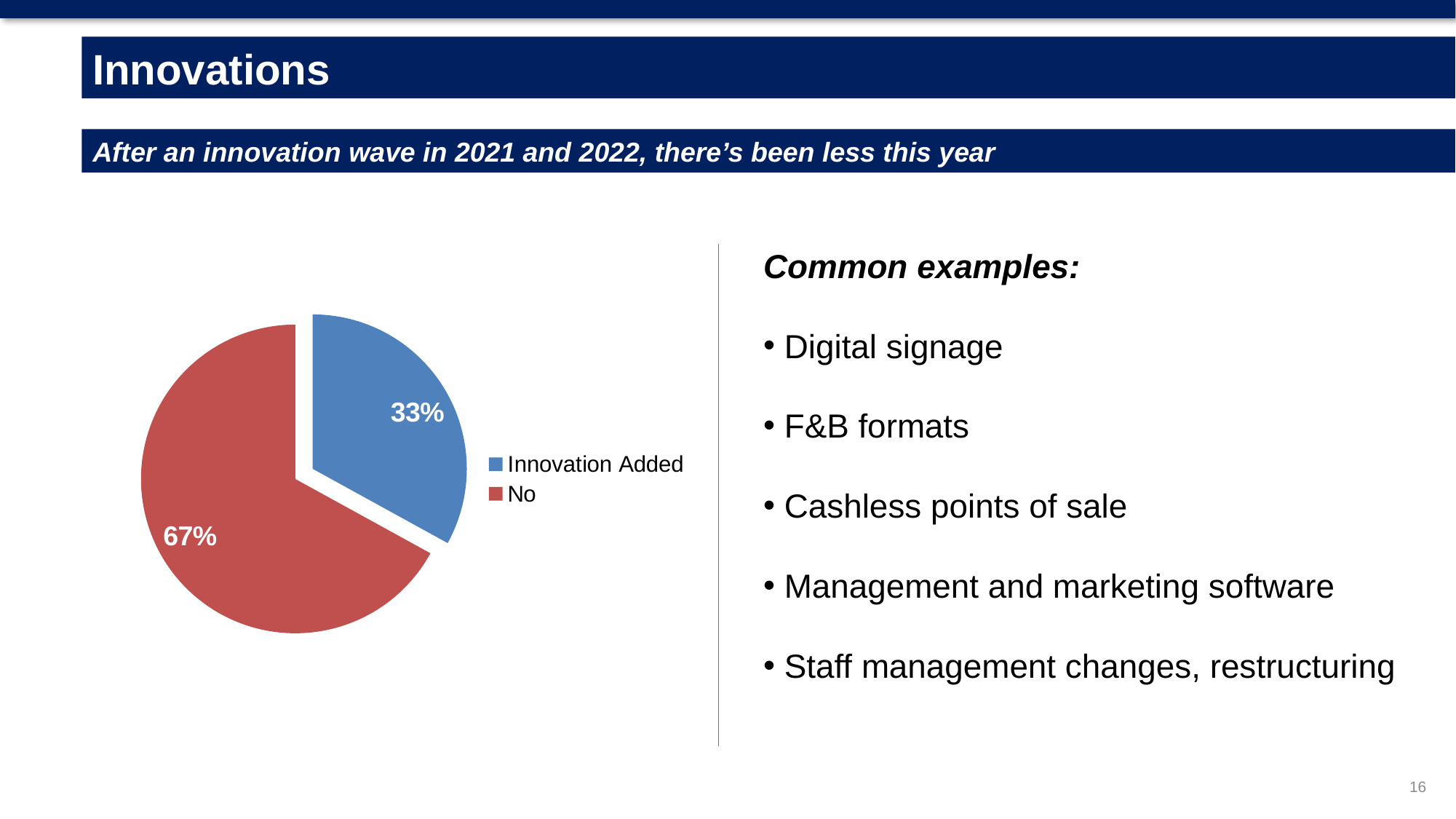
How many slices does the pie chart have? 2 What kind of chart is shown on the slide? Pie chart What share of the pie is labelled "No"? 67% Which slice of the pie chart is the smallest? Innovation Added Which is larger, the "Innovation Added" slice or the "No" slice? No What colour is the "Innovation Added" slice? Blue Which slice of the pie chart is the largest? No Which slice is pulled out (exploded) from the pie? Innovation Added What is the difference in percentage points between the "No" slice and the "Innovation Added" slice? 34 percentage points How many entries does the legend list? 2 What share of the pie is labelled "Innovation Added"? 33%